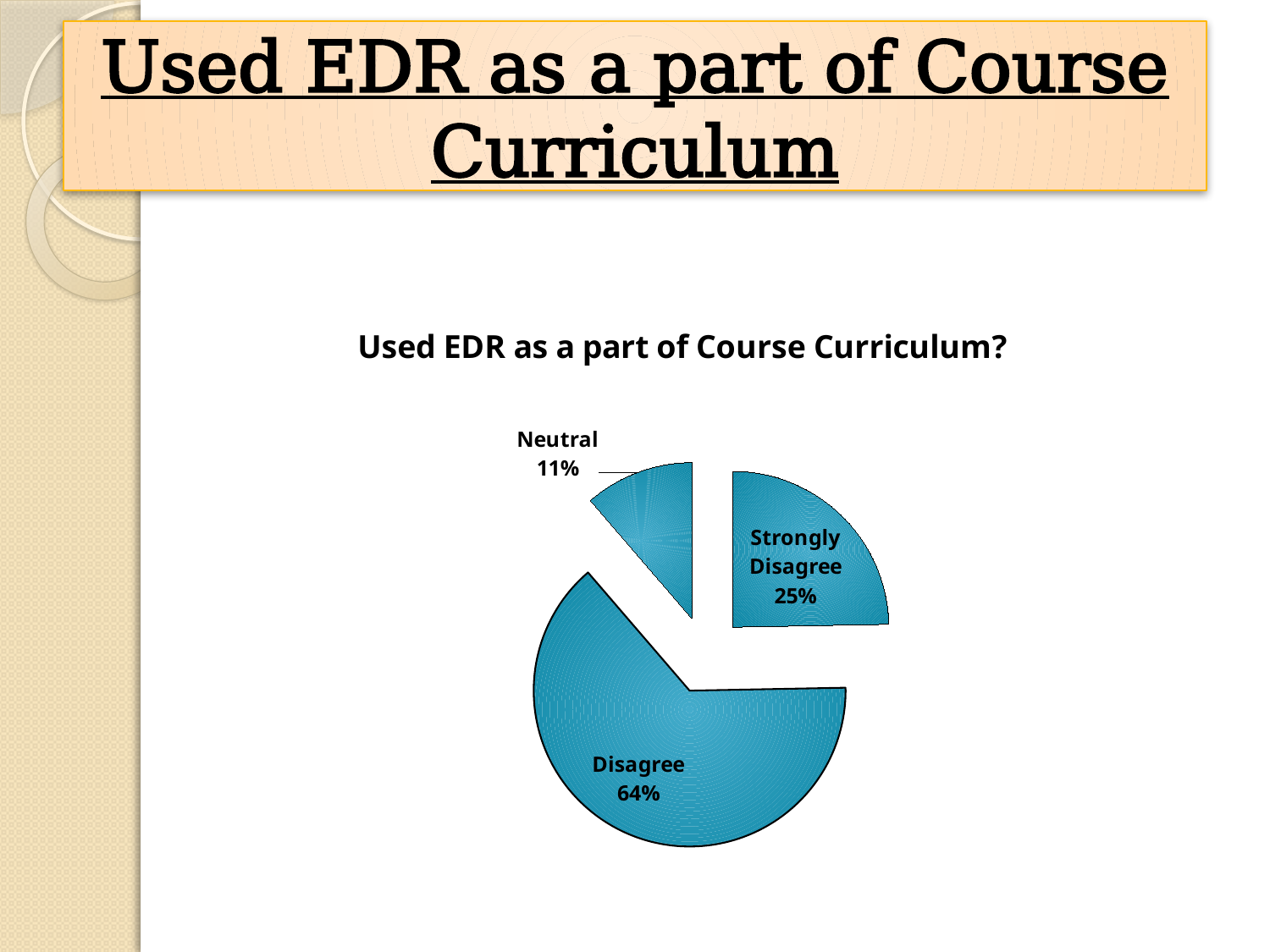
What percentage of the pie is labelled Neutral? 11% What percentage of the pie is labelled Strongly Disagree? 25% What is the difference in percentage points between the Disagree and Strongly Disagree slices? 39 What is the chart's title? Used EDR as a part of Course Curriculum? How many slices does the pie chart have? 3 Which slice of the pie is the smallest? Neutral What percentage of the pie is labelled Disagree? 64% What kind of chart is shown on the slide? pie chart Which is larger, the Strongly Disagree slice or the Neutral slice? Strongly Disagree Which slice of the pie is the largest? Disagree What is the difference in percentage points between the Strongly Disagree and Neutral slices? 14 What share of the pie does the Disagree slice represent? 64%